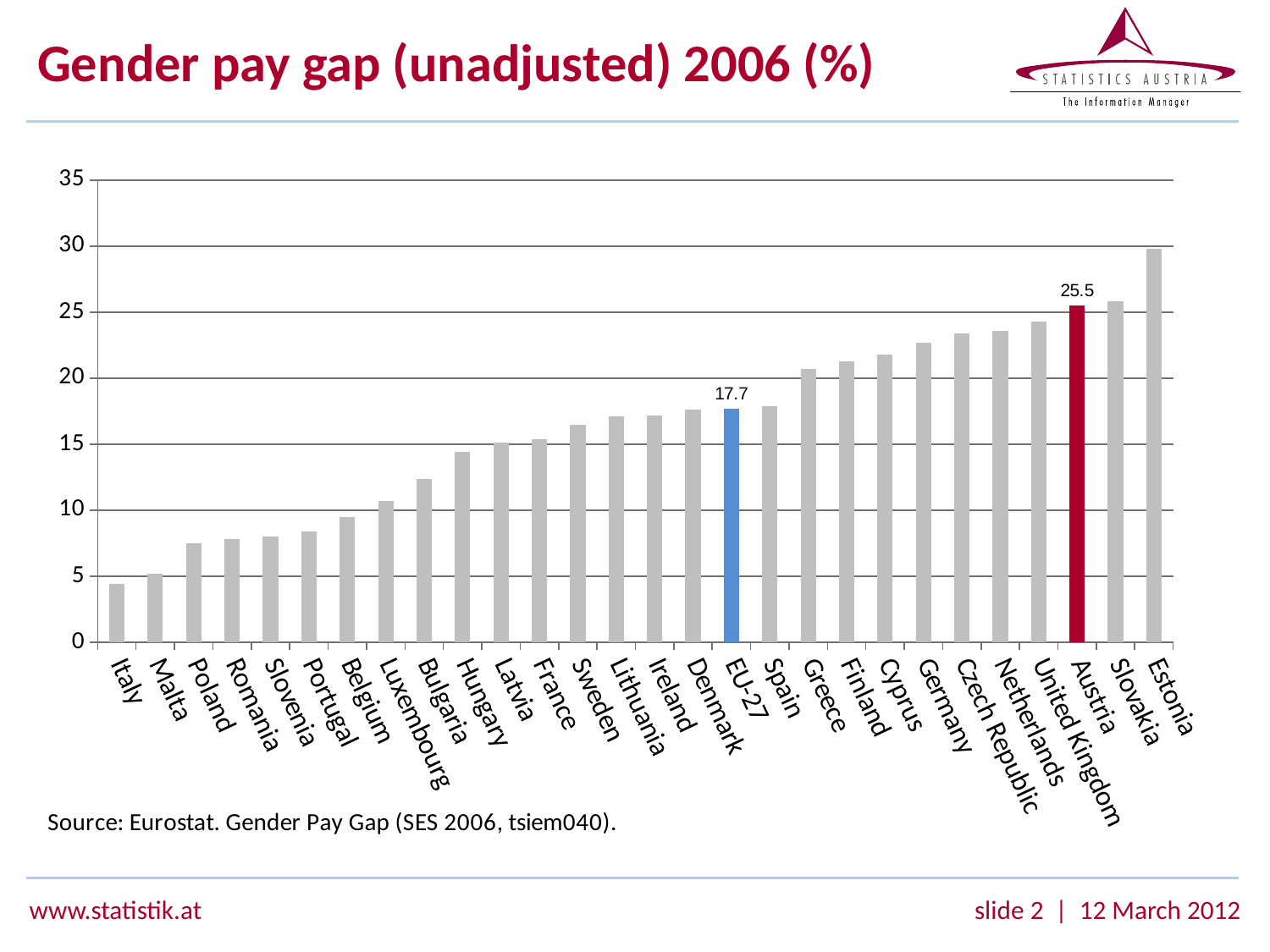
What kind of chart is shown on the slide? bar chart Is the value for Belgium greater or less than 10? less What is the gender pay gap value shown for Austria? 25.5 Do the values rise or fall from left to right along the x axis? rise What is the gender pay gap value shown for EU-27? 17.7 Which has a larger gender pay gap, Germany or Hungary? Germany Which country has the lowest gender pay gap in the chart? Italy Is the value for Italy greater or less than 5? less What is the difference between the values for Austria and EU-27? 7.8 Which country has the highest gender pay gap in the chart? Estonia How many bars (categories) are plotted in the chart? 28 Is the value for Estonia greater or less than 25? greater